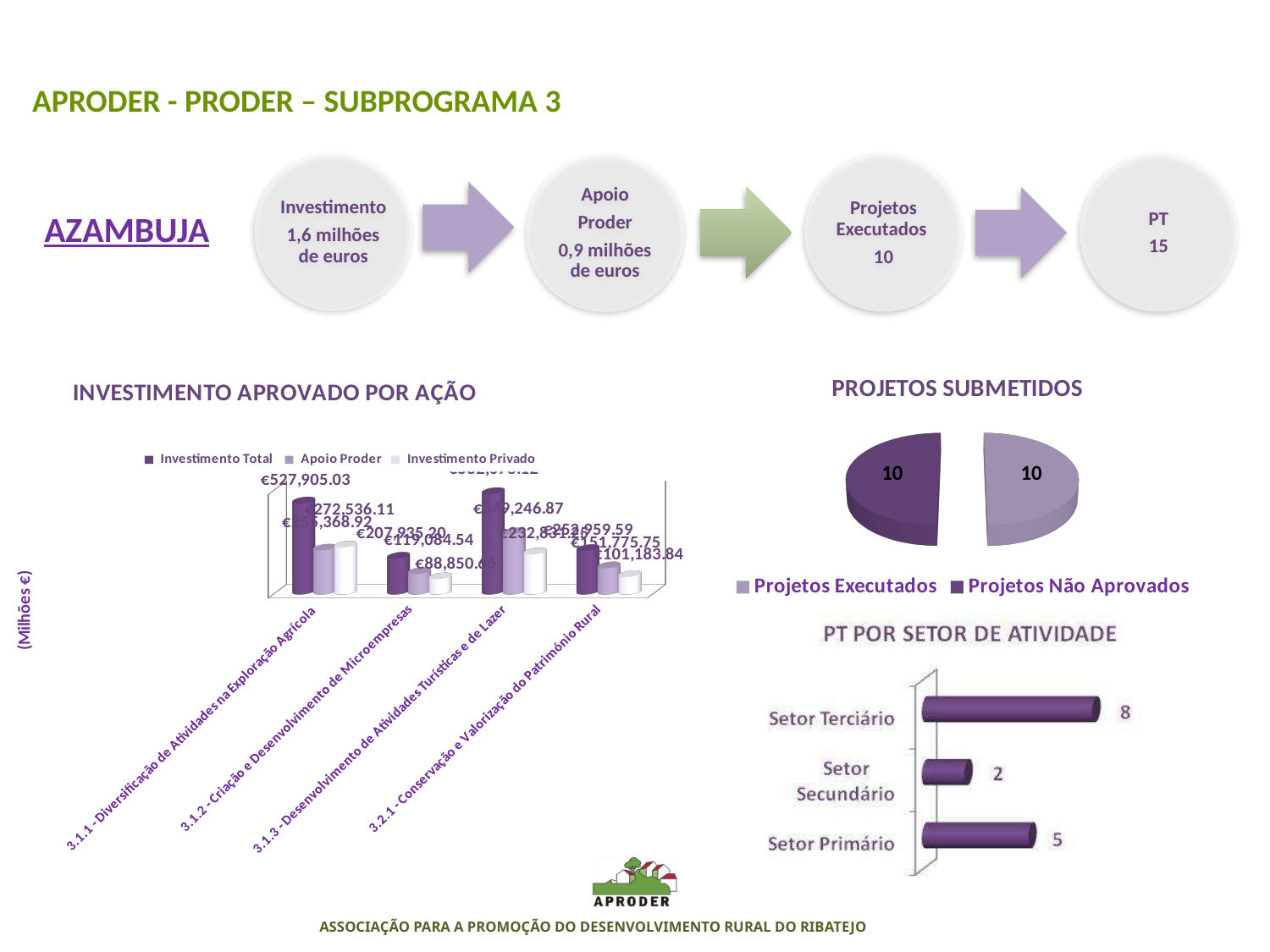
How many slices does the 'PROJETOS SUBMETIDOS' pie chart have? 2 In the 'INVESTIMENTO APROVADO POR AÇÃO' chart, what is the Investimento Total for 3.1.2 - Criação e Desenvolvimento de Microempresas? €207,935.20 In the 'PT POR SETOR DE ATIVIDADE' chart, what is the value for Setor Secundário? 2 What kind of chart is 'PT POR SETOR DE ATIVIDADE'? Bar chart In the 'PT POR SETOR DE ATIVIDADE' chart, which sector has the lowest value? Setor Secundário How many series does the legend of the 'INVESTIMENTO APROVADO POR AÇÃO' chart list? 3 In the 'PT POR SETOR DE ATIVIDADE' chart, what is the difference between Setor Terciário and Setor Primário? 3 In the 'PROJETOS SUBMETIDOS' pie chart, what share of the total do Projetos Não Aprovados represent? 50% In the 'INVESTIMENTO APROVADO POR AÇÃO' chart, what is the Investimento Total for 3.1.1 - Diversificação de Atividades na Exploração Agrícola? €527,905.03 In the 'PROJETOS SUBMETIDOS' pie chart, what is the value for Projetos Executados? 10 In the 'PT POR SETOR DE ATIVIDADE' chart, what is the value for Setor Terciário? 8 In the 'PT POR SETOR DE ATIVIDADE' chart, which sector has the highest value? Setor Terciário